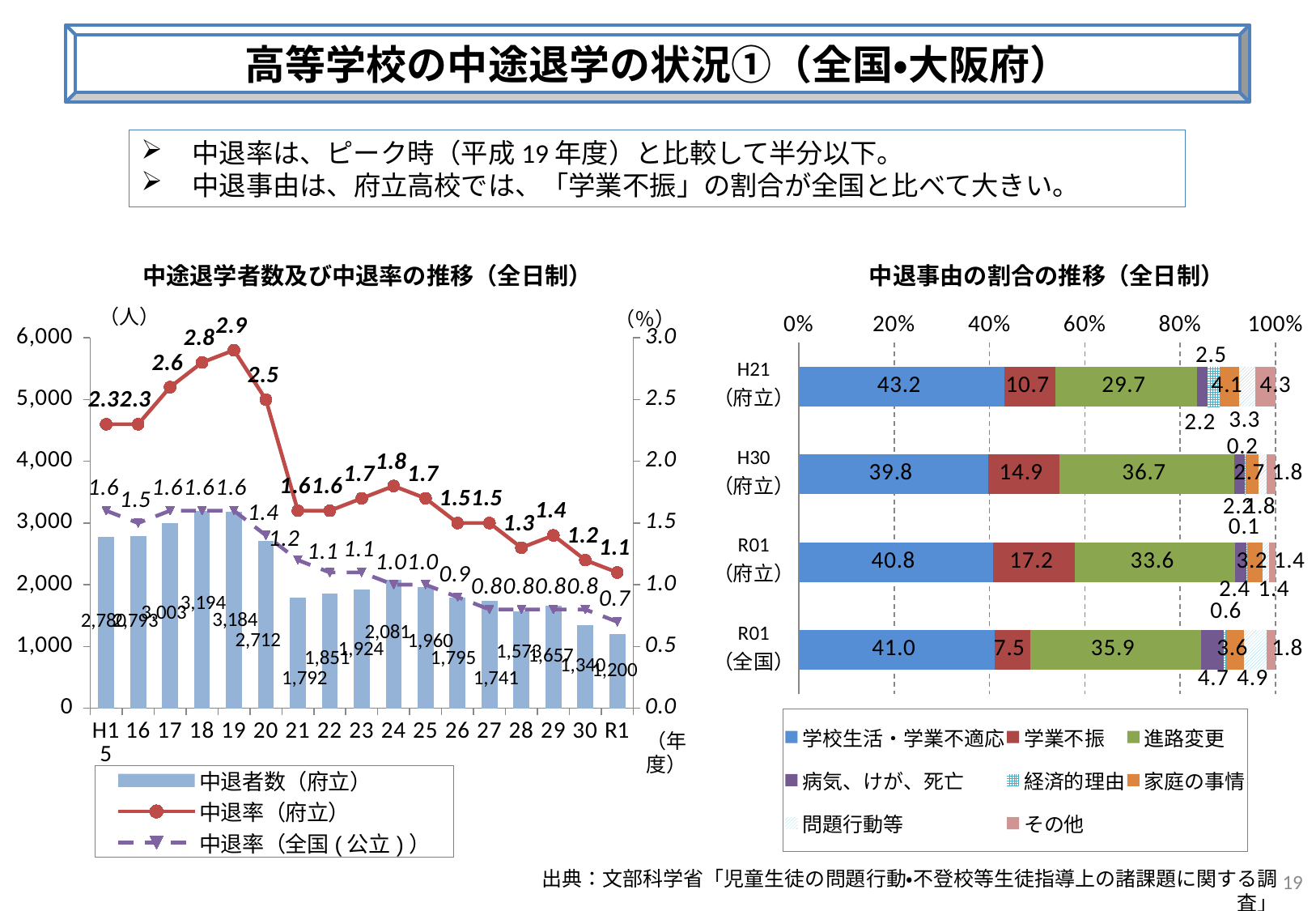
In the left chart, in which year does 中退率（府立） reach its highest value, and what is that value? H19, 2.9 In the left chart, what is the difference between the 中退者数（府立） for H18 and for R1? 1,994 In the left chart, does 中退率（全国(公立)） generally rise or fall from H15 to R1? fall In the right chart, which has the larger 学業不振 share: R01（府立） or R01（全国）? R01（府立） What kind of chart is the right chart (中退事由の割合の推移)? stacked horizontal bar chart How many series does the legend of the left chart list? 3 In the left chart, which year has the lowest 中退者数（府立） bar? R1 (1,200) How many entries does the legend of the right chart list? 8 How many years (categories) are shown on the x axis of the left chart? 17 In the left chart (中途退学者数及び中退率の推移), what is the number of 中退者数（府立） for H19? 3,184 In the right chart (中退事由の割合の推移), what is the share of 学業不振 for R01（府立）? 17.2 In the left chart, what is the 中退率（府立） value for R1? 1.1